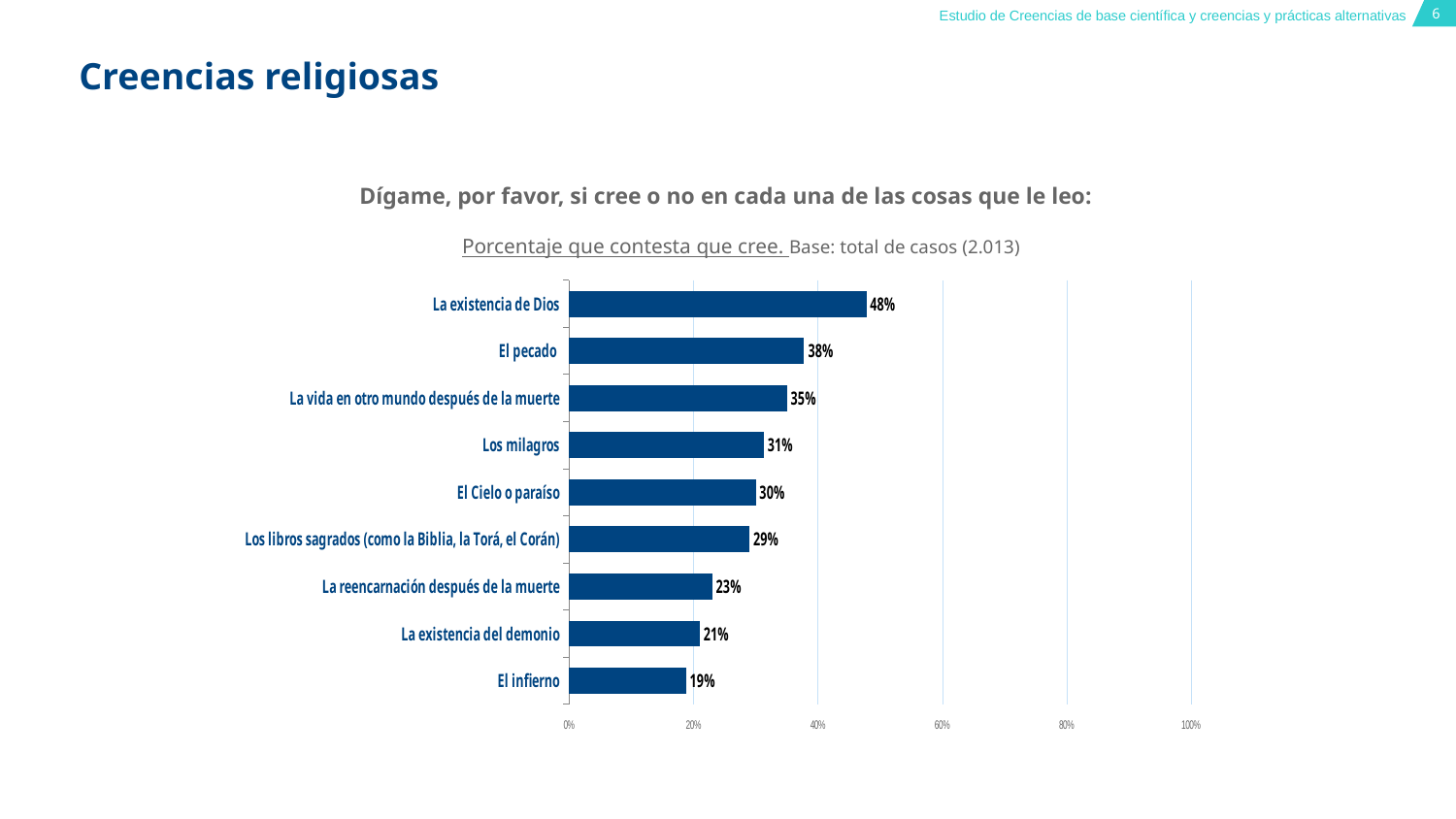
How many categories are shown in the chart? 9 What is the value shown for 'El pecado'? 38% Which category has the highest percentage of believers? La existencia de Dios What percentage is shown for 'La reencarnación después de la muerte'? 23% What is the difference in percentage points between 'La existencia de Dios' and 'El infierno'? 29 What percentage of respondents say they believe in 'La existencia de Dios'? 48% What is the difference between 'Los milagros' and 'El Cielo o paraíso'? 1 percentage point Is the value for 'La existencia del demonio' greater or less than 40%? less Which category has the lowest percentage of believers? El infierno What is the base (total number of cases) stated for the chart? 2.013 What kind of chart is shown on the slide? Bar chart Which is larger, the value for 'La vida en otro mundo después de la muerte' or the value for 'Los libros sagrados (como la Biblia, la Torá, el Corán)'? La vida en otro mundo después de la muerte